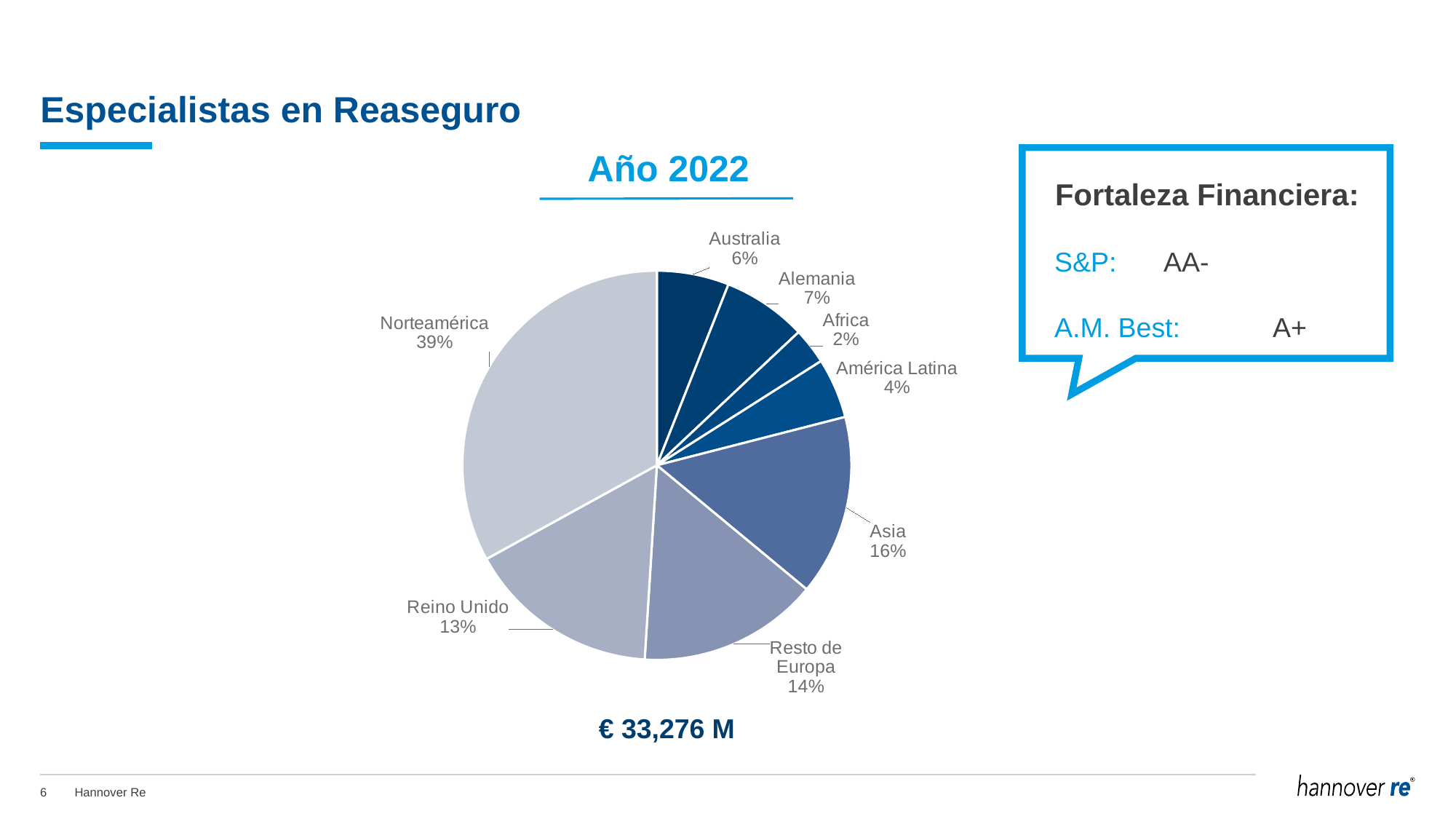
What is the difference in percentage points between Norteamérica and Asia? 23 Which is larger, the share for Alemania or the share for Australia? Alemania What kind of chart is shown on the slide? Pie chart What is the value shown for Resto de Europa? 14% What total amount is printed below the pie chart? € 33,276 M What is the value shown for Asia? 16% What is the value shown for Reino Unido? 13% What share of the pie does Norteamérica hold? 39% How many regions are shown in the pie chart? 8 Which region has the smallest slice of the pie? Africa Which region has the largest slice of the pie? Norteamérica What is the title of the chart? Año 2022